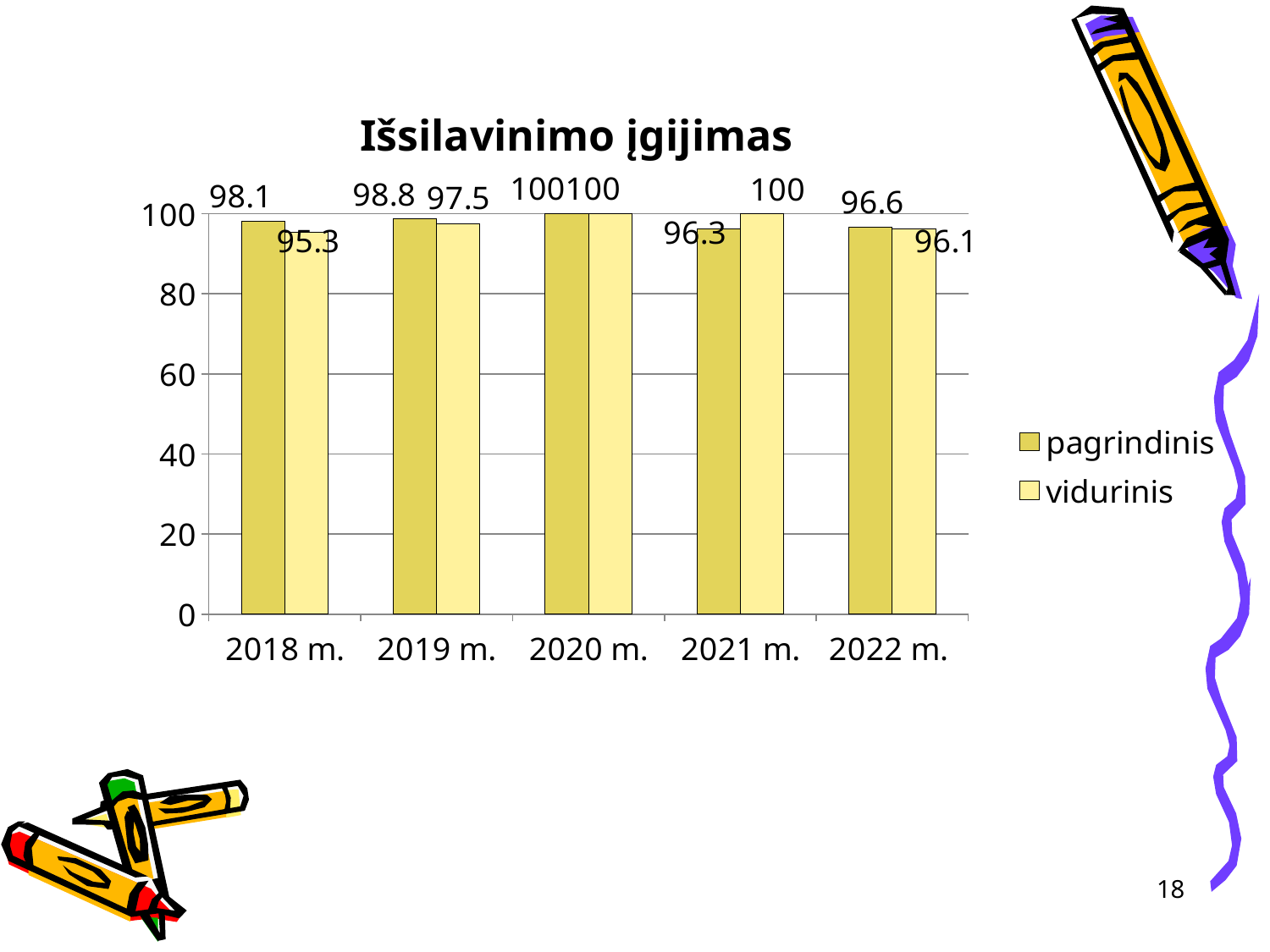
What is the value for vidurinis in 2019 m.? 97.5 What is the value for vidurinis in 2022 m.? 96.1 In which year is the pagrindinis value the lowest? 2021 m. What is the difference between the pagrindinis and vidurinis values in 2018 m.? 2.8 How many series does the legend list? 2 What is the title of the chart? Išsilavinimo įgijimas In which year is the vidurinis value the lowest? 2018 m. What is the value for vidurinis in 2018 m.? 95.3 What is the value for pagrindinis in 2018 m.? 98.1 How many years are shown on the x axis? 5 What is the value for pagrindinis in 2021 m.? 96.3 Which is larger in 2021 m., pagrindinis or vidurinis? vidurinis